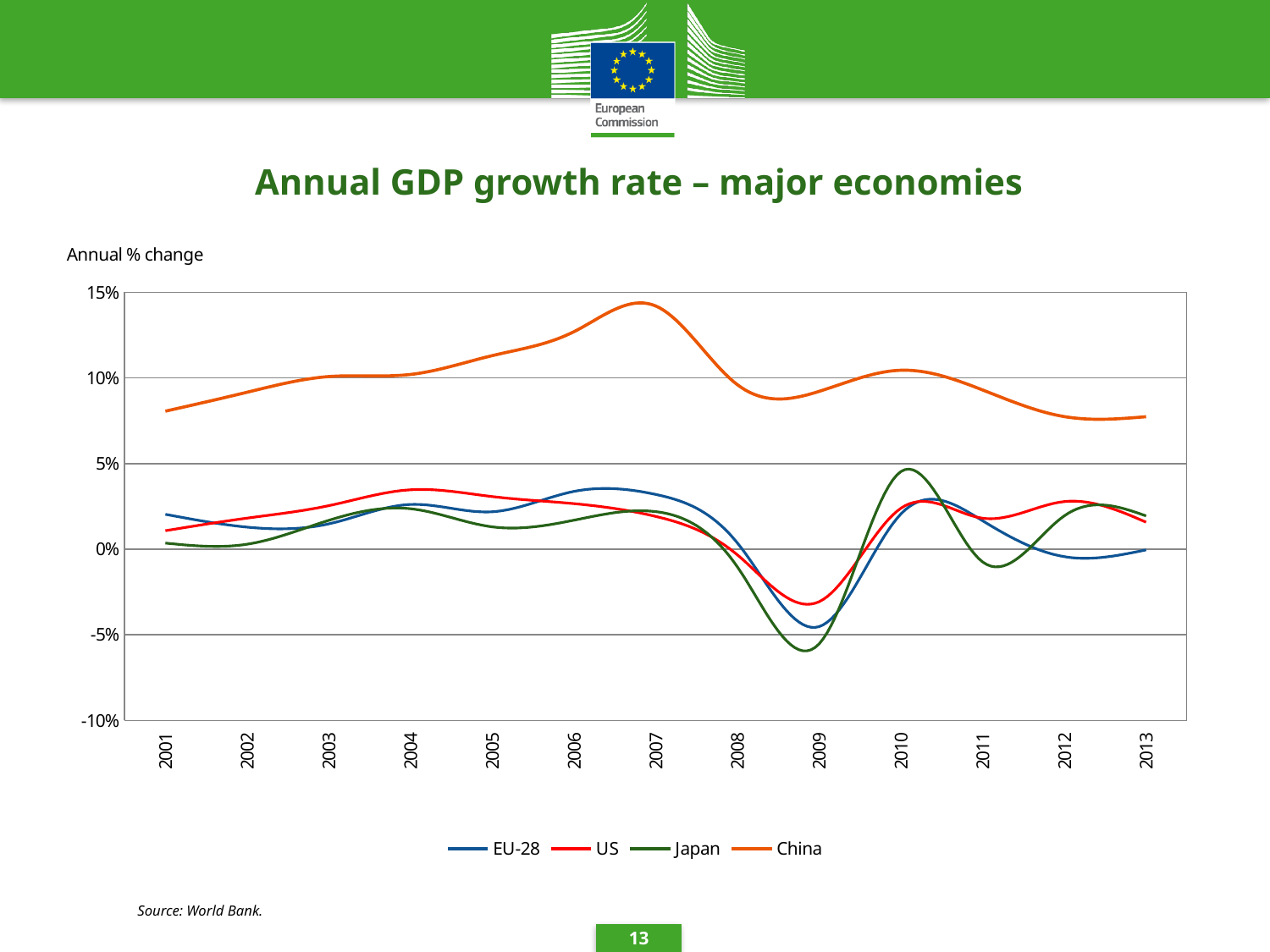
Which economy has the lowest GDP growth rate in 2009? Japan How many series does the legend list? 4 Is the value for China in 2007 greater or less than 10%? greater Which series is drawn in orange? China How many years are shown on the x axis? 13 Which is larger in 2013, the value for China or the value for the US? China Which economy has the highest GDP growth rate in 2007? China Does the value for China rise or fall between 2007 and 2009? fall What is the title of the chart? Annual GDP growth rate – major economies Is the value for China in 2013 greater or less than 10%? less Is the value for Japan in 2009 greater or less than -5%? less What kind of chart is shown on the slide? line chart